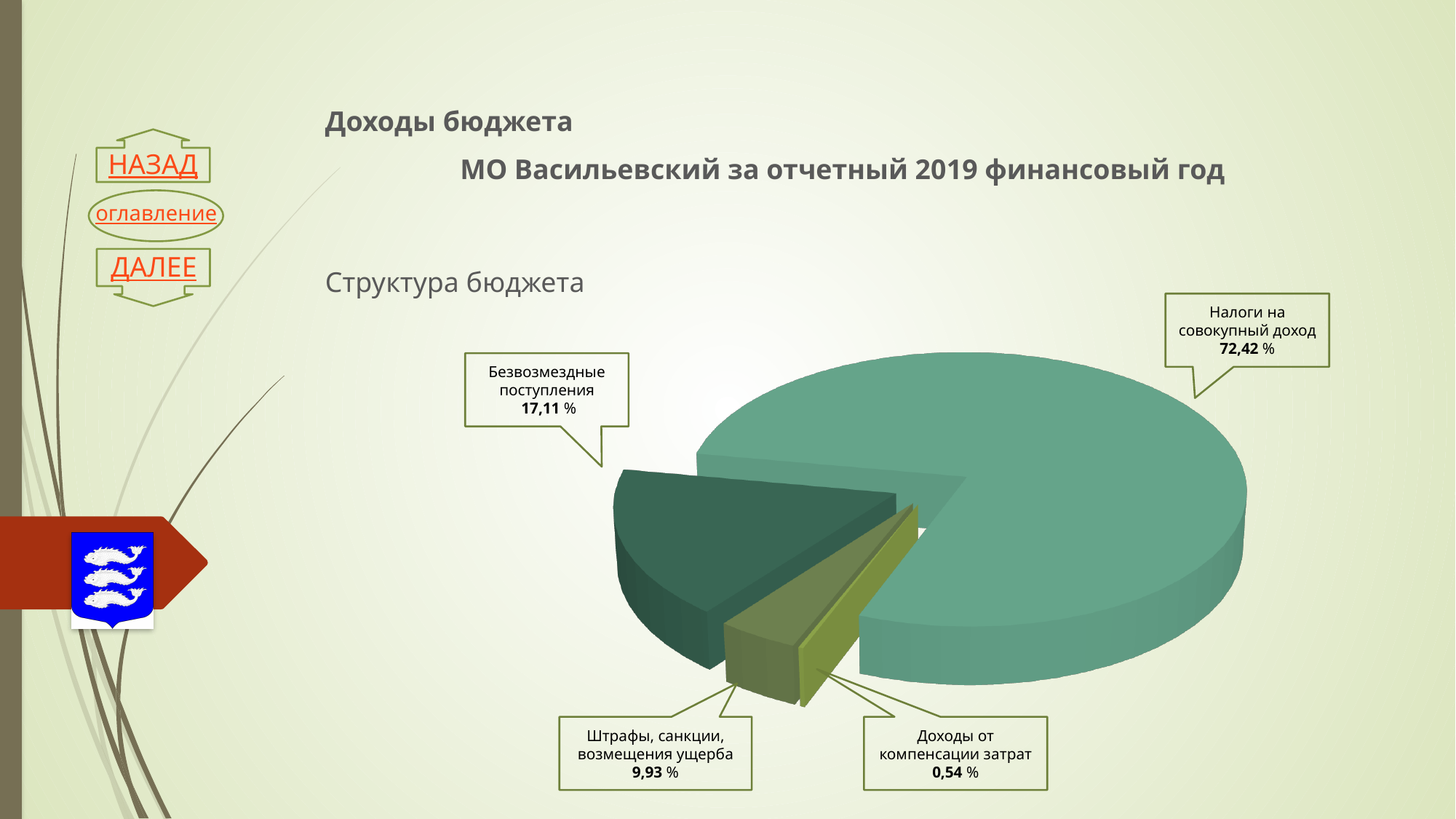
Which is larger: the share of Штрафы, санкции, возмещения ущерба or the share of Доходы от компенсации затрат? Штрафы, санкции, возмещения ущерба Which category has the largest share of the pie? Налоги на совокупный доход Which category has the smallest share of the pie? Доходы от компенсации затрат What is the title of the chart? Структура бюджета How many slices does the pie chart have? 4 What is the share of Доходы от компенсации затрат in the pie chart? 0,54 % What is the share of Безвозмездные поступления in the pie chart? 17,11 % What is the share of Налоги на совокупный доход in the pie chart? 72,42 % What is the difference in percentage points between Безвозмездные поступления and Штрафы, санкции, возмещения ущерба? 7,18 % What is the difference in percentage points between Налоги на совокупный доход and Безвозмездные поступления? 55,31 % What is the share of Штрафы, санкции, возмещения ущерба in the pie chart? 9,93 % What kind of chart is shown on the slide? Pie chart